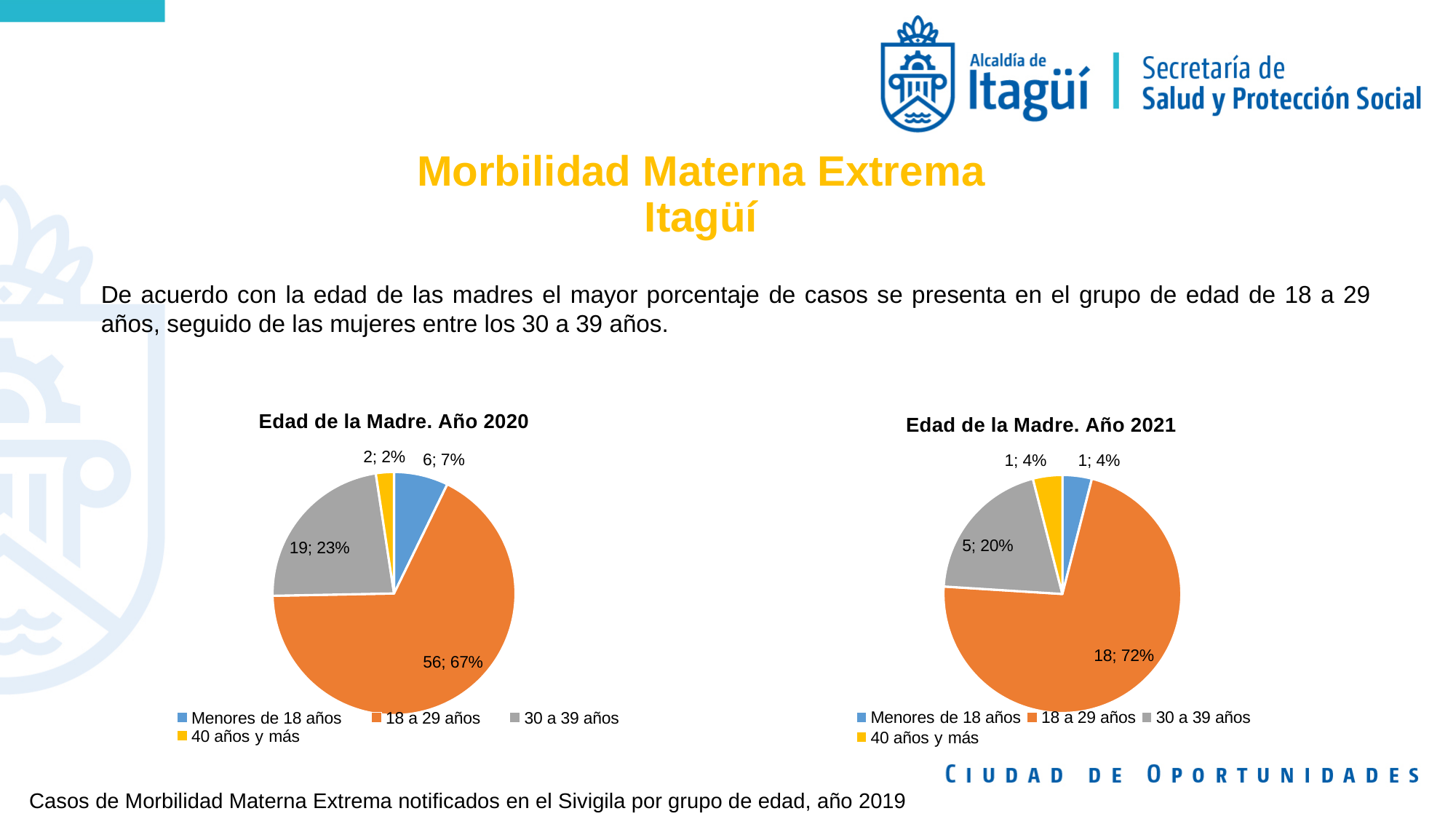
What type of chart is 'Edad de la Madre. Año 2020'? Pie chart In the 'Edad de la Madre. Año 2020' chart, how many cases are in the '18 a 29 años' group? 56 In the 'Edad de la Madre. Año 2021' chart, which age group has the largest slice? 18 a 29 años In the 'Edad de la Madre. Año 2020' chart, what share of the pie does '30 a 39 años' represent? 23% In the 'Edad de la Madre. Año 2021' chart, what is the total number of cases across all slices? 25 In the 'Edad de la Madre. Año 2020' chart, which age group has the smallest slice? 40 años y más In the 'Edad de la Madre. Año 2020' chart, what is the difference in cases between '18 a 29 años' and '30 a 39 años'? 37 In the 'Edad de la Madre. Año 2020' chart, what is the total number of cases across all slices? 83 Which chart has more cases in the '18 a 29 años' group, 'Edad de la Madre. Año 2020' or 'Edad de la Madre. Año 2021'? Edad de la Madre. Año 2020 How many age groups does the legend of the 'Edad de la Madre. Año 2021' chart list? 4 In the 'Edad de la Madre. Año 2021' chart, what share of the pie does '18 a 29 años' represent? 72% In the 'Edad de la Madre. Año 2021' chart, how many cases are in the '30 a 39 años' group? 5